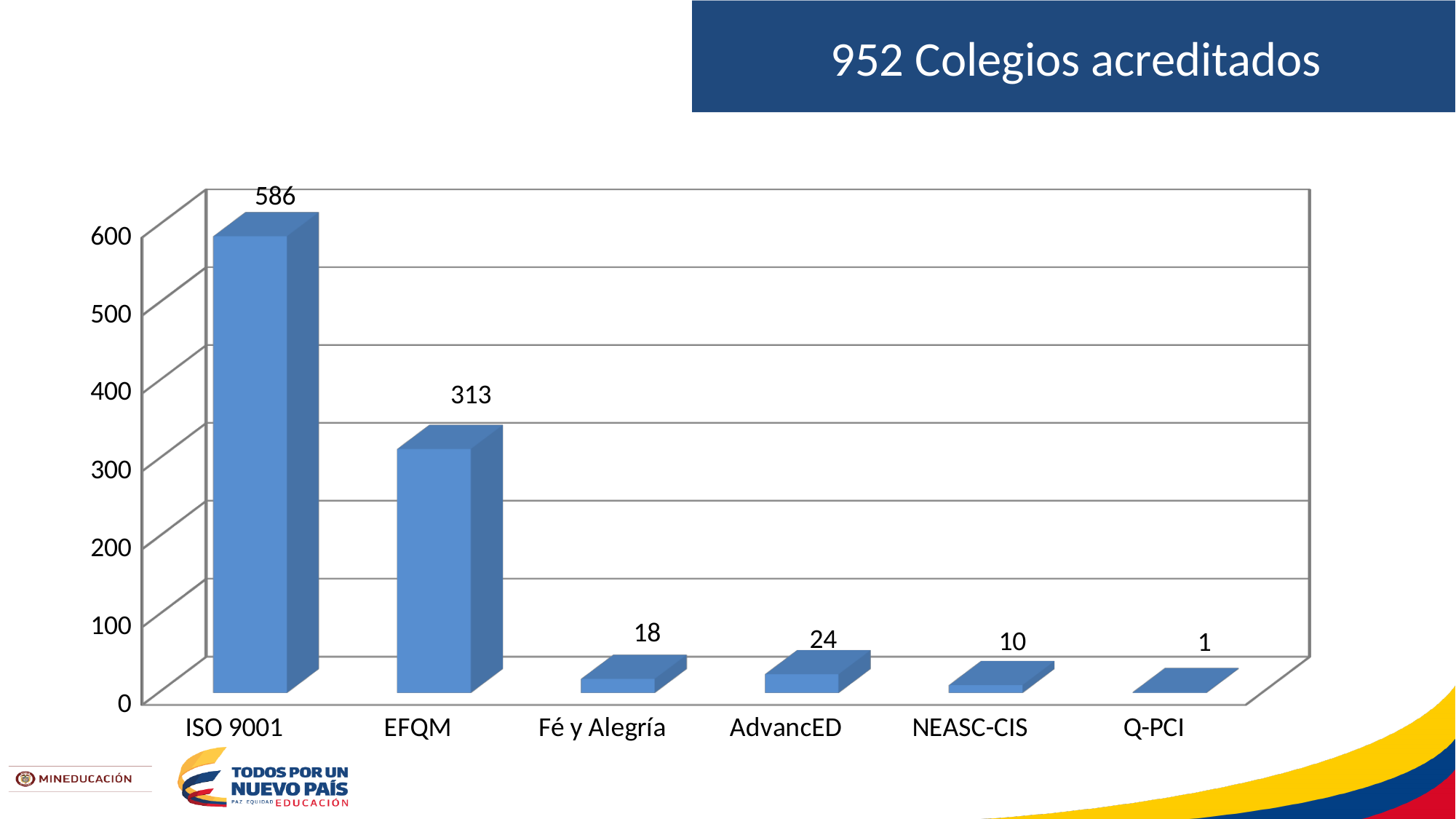
What is the difference between the values for ISO 9001 and EFQM? 273 What is the value for EFQM? 313 What is the value for NEASC-CIS? 10 What is the value for ISO 9001? 586 Which is larger, the value for AdvancED or the value for Fé y Alegría? AdvancED What is the value for AdvancED? 24 Which category has the highest value? ISO 9001 What is the value for Fé y Alegría? 18 Which category has the lowest value? Q-PCI What is the value for Q-PCI? 1 How many categories are shown on the x axis? 6 What kind of chart is shown on the slide? Bar chart